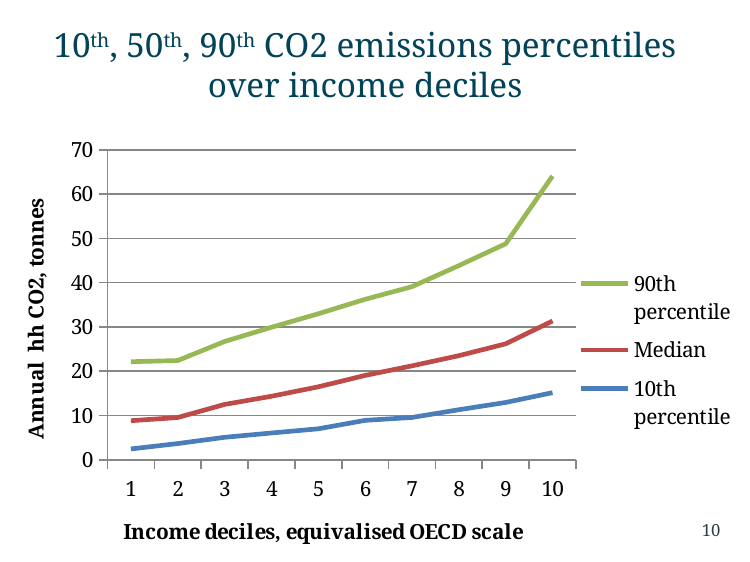
Is the value of the 90th percentile series at income decile 10 greater or less than 60? greater Is the value of the 90th percentile series at income decile 5 greater or less than 30? greater At which income decile does the 90th percentile series reach its highest value? 10 What is the label of the y axis? Annual hh CO2, tonnes Do the values of the 90th percentile series rise or fall as income decile increases? rise How many series does the legend list? 3 At income decile 10, which series has the larger value, the 90th percentile or the Median? 90th percentile How many income deciles are plotted along the x axis? 10 Is the value of the 10th percentile series at income decile 1 greater or less than 10? less What kind of chart is shown on the slide? line chart